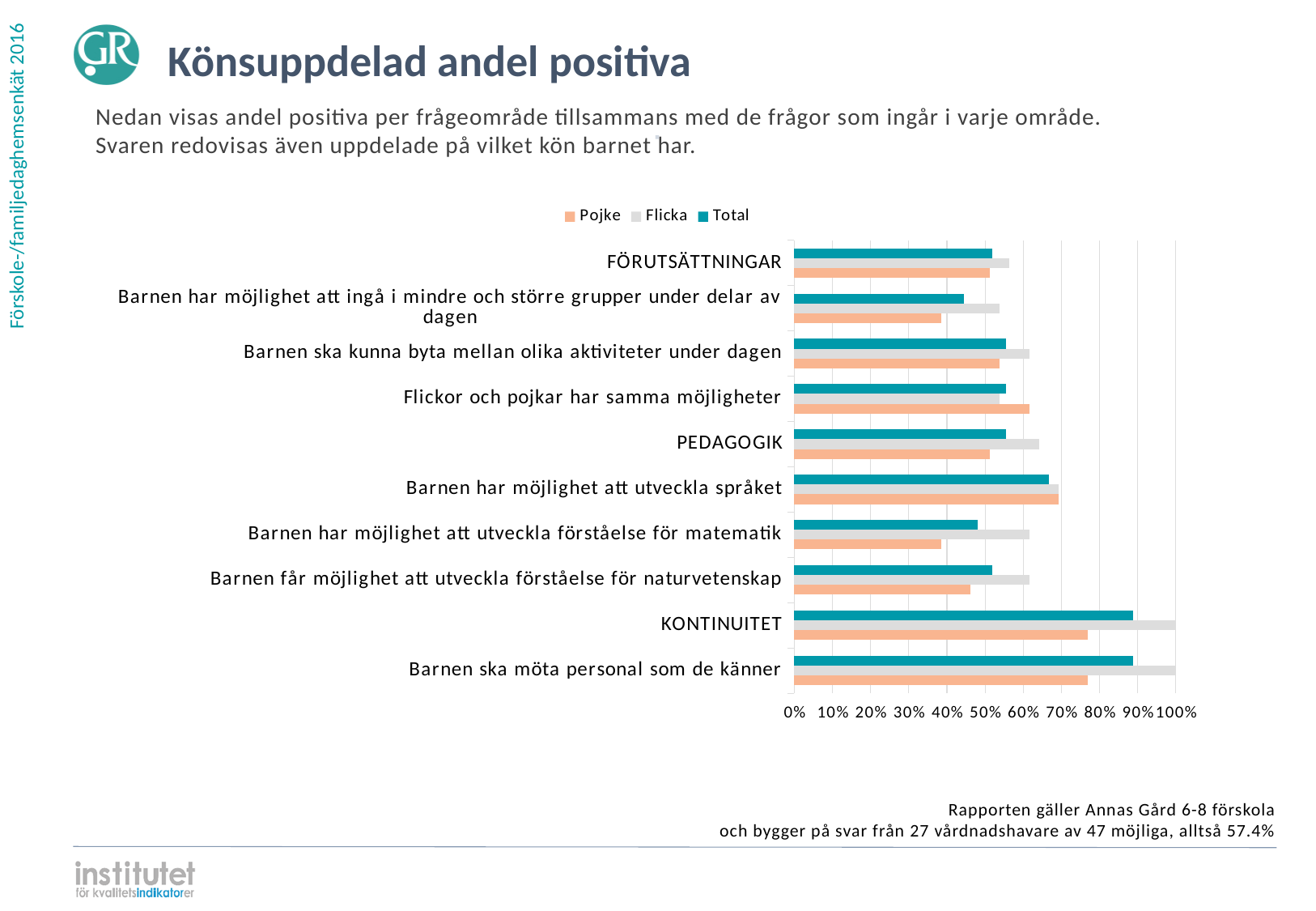
Is the Pojke value for KONTINUITET greater or less than 70%? greater Is the Pojke value for 'Barnen har möjlighet att utveckla förståelse för matematik' greater or less than 50%? less Is the Total value for 'Barnen har möjlighet att utveckla språket' greater or less than 60%? greater How many categories are plotted on the y axis of the chart? 10 For KONTINUITET, which series has the highest value? Flicka For 'Flickor och pojkar har samma möjligheter', which is larger, the Pojke value or the Flicka value? Pojke For 'Barnen har möjlighet att utveckla förståelse för matematik', which is larger, the Flicka value or the Pojke value? Flicka What kind of chart is shown on the slide? bar chart Which series is shown in orange in the legend? Pojke How many series does the legend list? 3